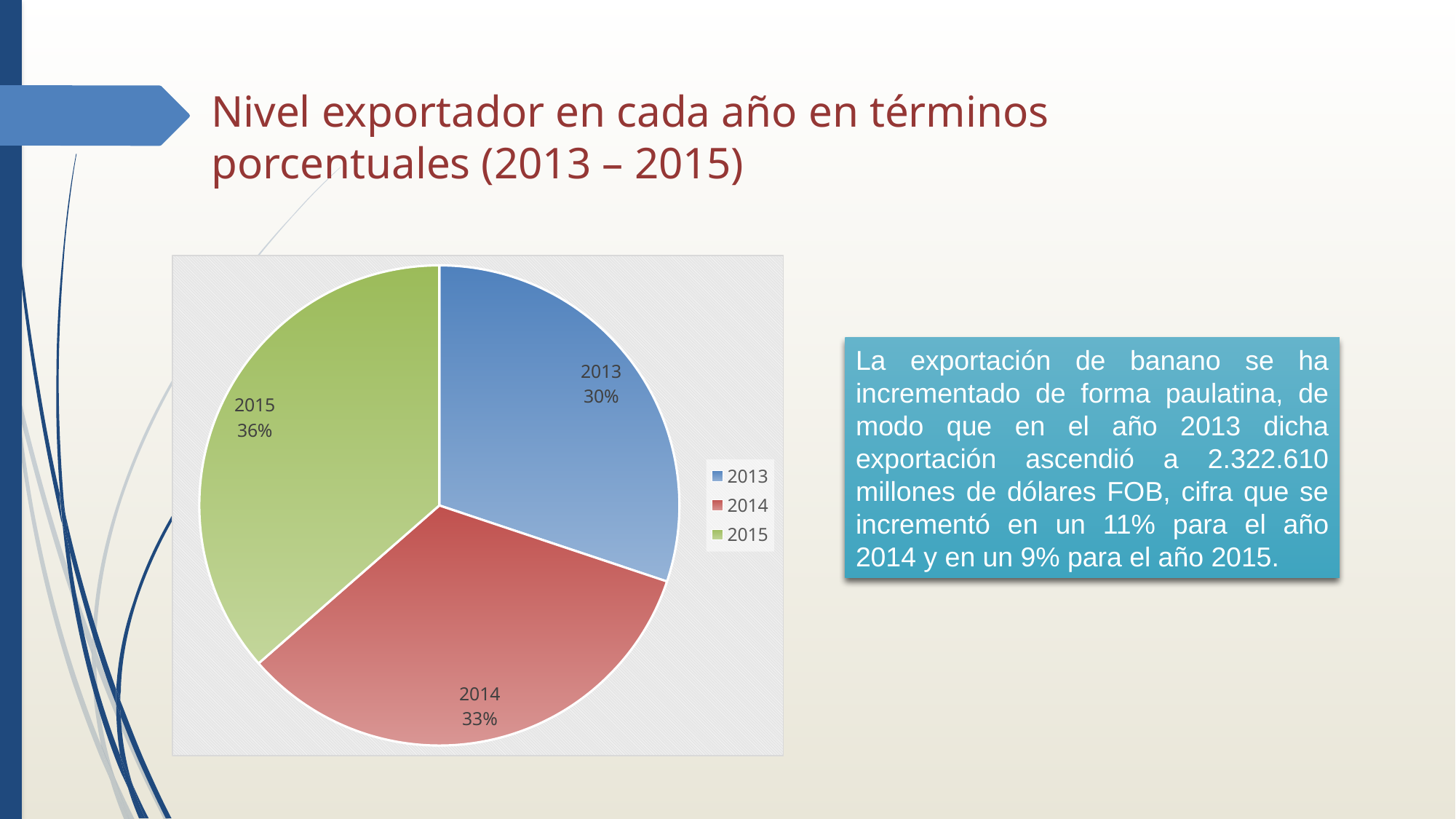
What share of the pie does 2014 have? 33% What share of the pie does 2013 have? 30% What colour is the slice for 2015? green What is the difference in percentage points between the 2015 slice and the 2013 slice? 6 How many entries does the legend list? 3 Which year has the smallest slice of the pie? 2013 Which slice is larger, 2014 or 2013? 2014 What kind of chart is shown on the slide? pie chart What share of the pie does 2015 have? 36% Do the percentages rise or fall from 2013 to 2015? rise Which year has the largest slice of the pie? 2015 How many slices does the pie chart have? 3